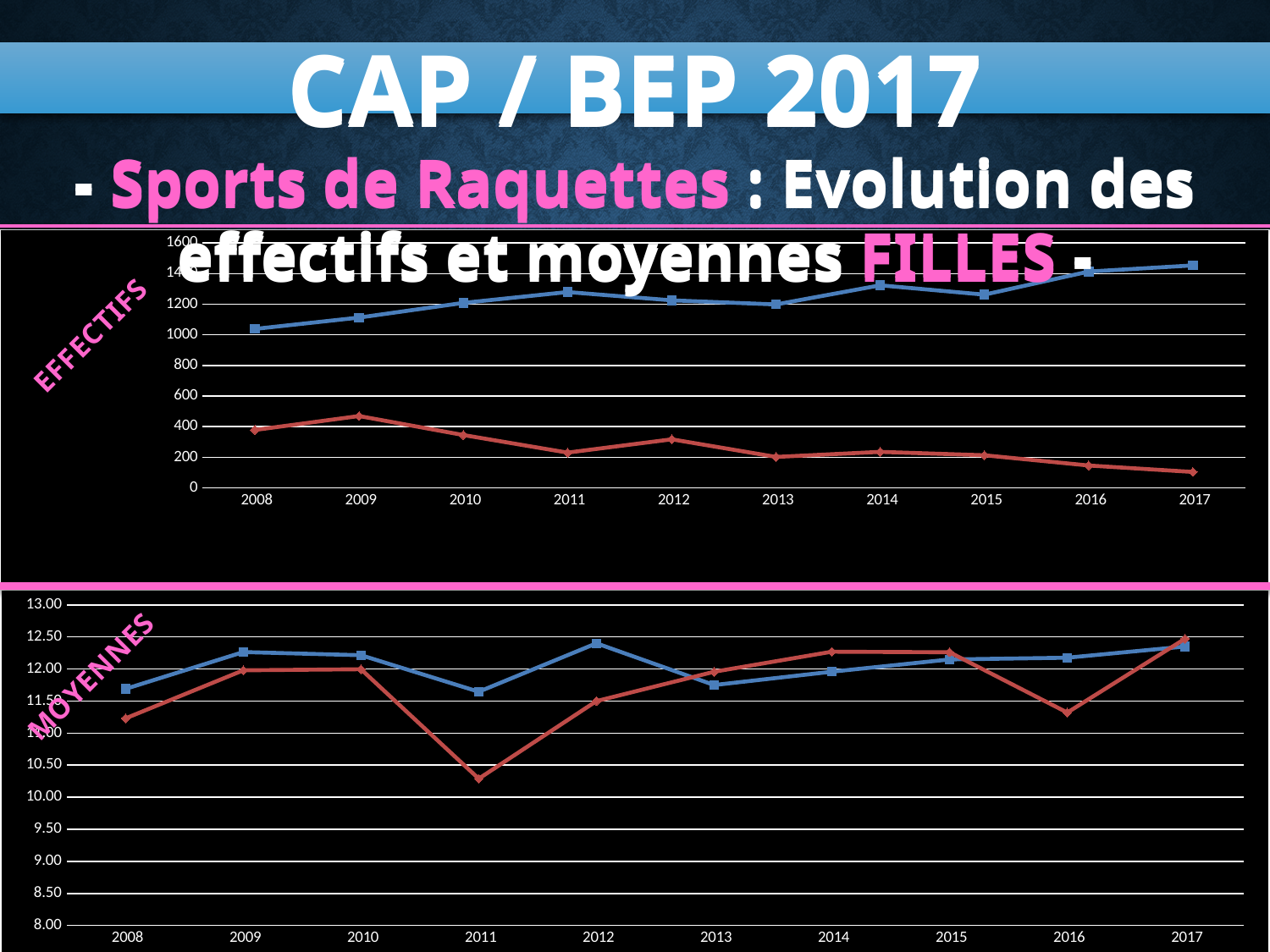
In the top chart labelled EFFECTIFS, in which year does the blue line reach its highest value? 2017 In the bottom chart labelled MOYENNES, in which year does the red line reach its lowest value? 2011 What kind of chart is the top chart labelled EFFECTIFS? Line chart In the top chart labelled EFFECTIFS, is the red line's value for 2017 greater or less than 200? less In the top chart labelled EFFECTIFS, does the red line generally rise or fall from 2008 to 2017? Fall In the bottom chart labelled MOYENNES, which line has the higher value in 2016, the blue line or the red line? The blue line In the bottom chart labelled MOYENNES, is the red line's value for 2011 greater or less than 10.50? less In the bottom chart labelled MOYENNES, is the blue line's value for 2012 greater or less than 12.00? greater In the top chart labelled EFFECTIFS, does the blue line generally rise or fall from 2008 to 2017? Rise In the top chart labelled EFFECTIFS, in which year does the red line reach its highest value? 2009 How many years are shown on the x axis of the bottom chart labelled MOYENNES? 10